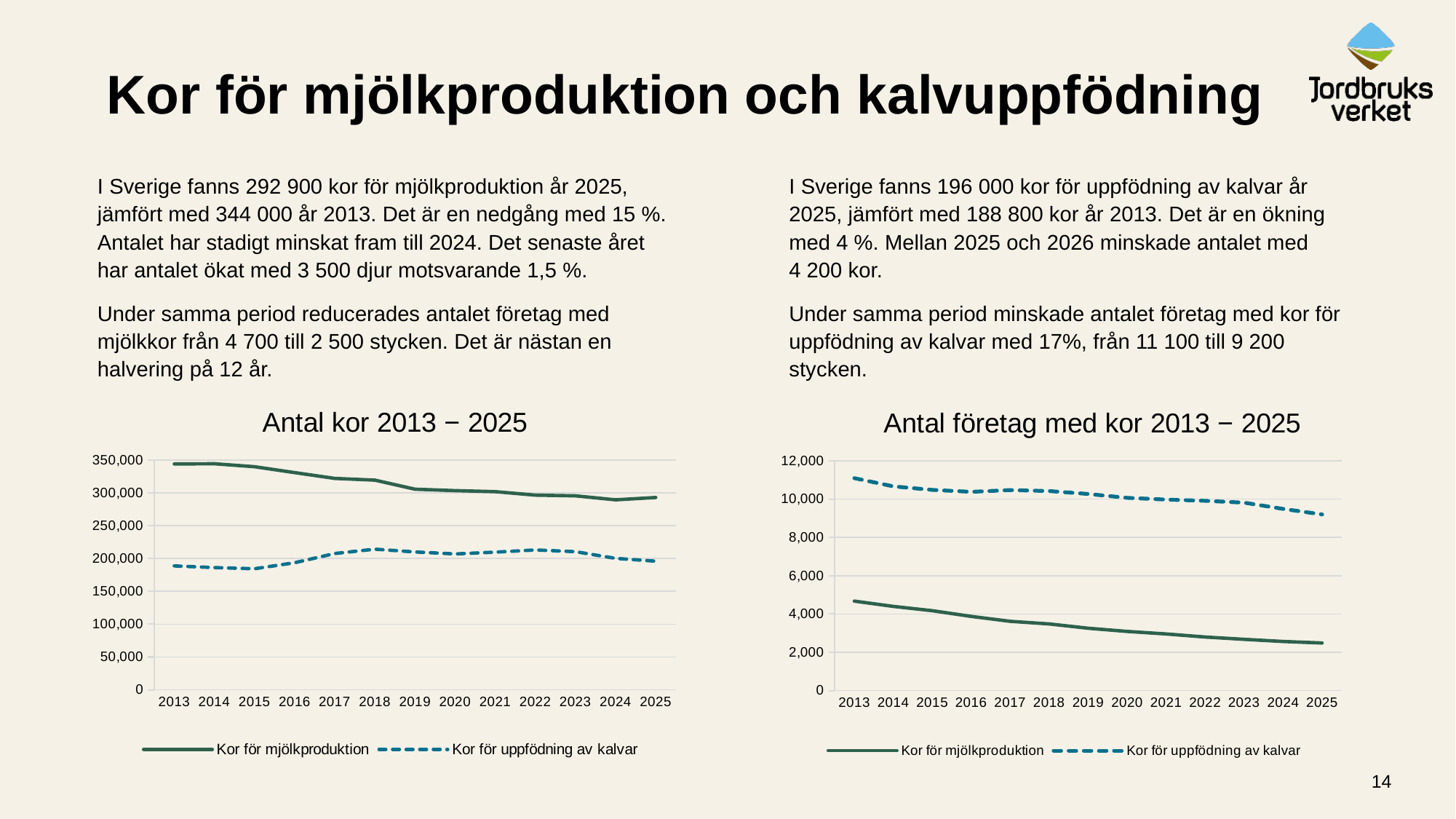
In the "Antal kor 2013 − 2025" chart, does the Kor för mjölkproduktion line overall rise or fall from 2013 to 2025? fall In the "Antal företag med kor 2013 − 2025" chart, in which year is the Kor för mjölkproduktion series lowest? 2025 In the "Antal företag med kor 2013 − 2025" chart, is the value for Kor för mjölkproduktion in 2025 greater or less than 4,000? less In the "Antal företag med kor 2013 − 2025" chart, which series has the higher value in 2013? Kor för uppfödning av kalvar In the "Antal kor 2013 − 2025" chart, is the value for Kor för uppfödning av kalvar in 2013 greater or less than 200,000? less How many series does the legend of the "Antal kor 2013 − 2025" chart list? 2 In the "Antal företag med kor 2013 − 2025" chart, is the value for Kor för uppfödning av kalvar in 2013 greater or less than 10,000? greater In the "Antal kor 2013 − 2025" chart, which series is drawn with a dashed line? Kor för uppfödning av kalvar How many years are shown on the x axis of the "Antal företag med kor 2013 − 2025" chart? 13 In the "Antal kor 2013 − 2025" chart, which series has the higher value in 2025? Kor för mjölkproduktion What kind of chart is the "Antal kor 2013 − 2025" chart? line chart